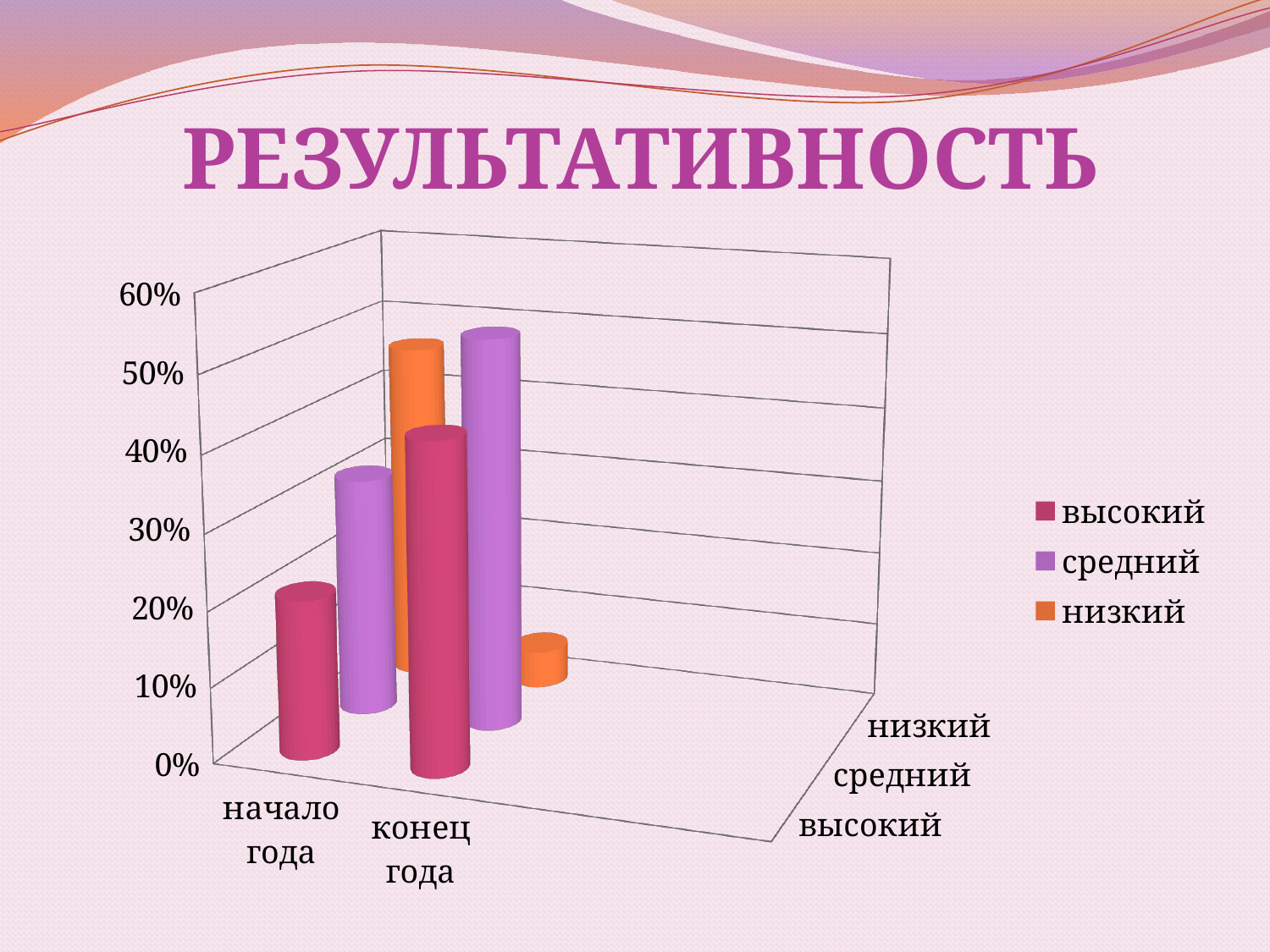
How many series does the legend list? 3 Is the value for низкий at конец года greater or less than 20%? less Is the value for низкий at начало года greater or less than 30%? greater What is the title of the slide with the chart? РЕЗУЛЬТАТИВНОСТЬ Which series is shown in orange in the legend? низкий Does the низкий series rise or fall from начало года to конец года? fall How many categories are shown on the x axis? 2 For the высокий series, which is larger: начало года or конец года? конец года Is the value for высокий at конец года greater or less than 30%? greater What kind of chart is shown on the slide? bar chart For the низкий series, which is larger: начало года or конец года? начало года